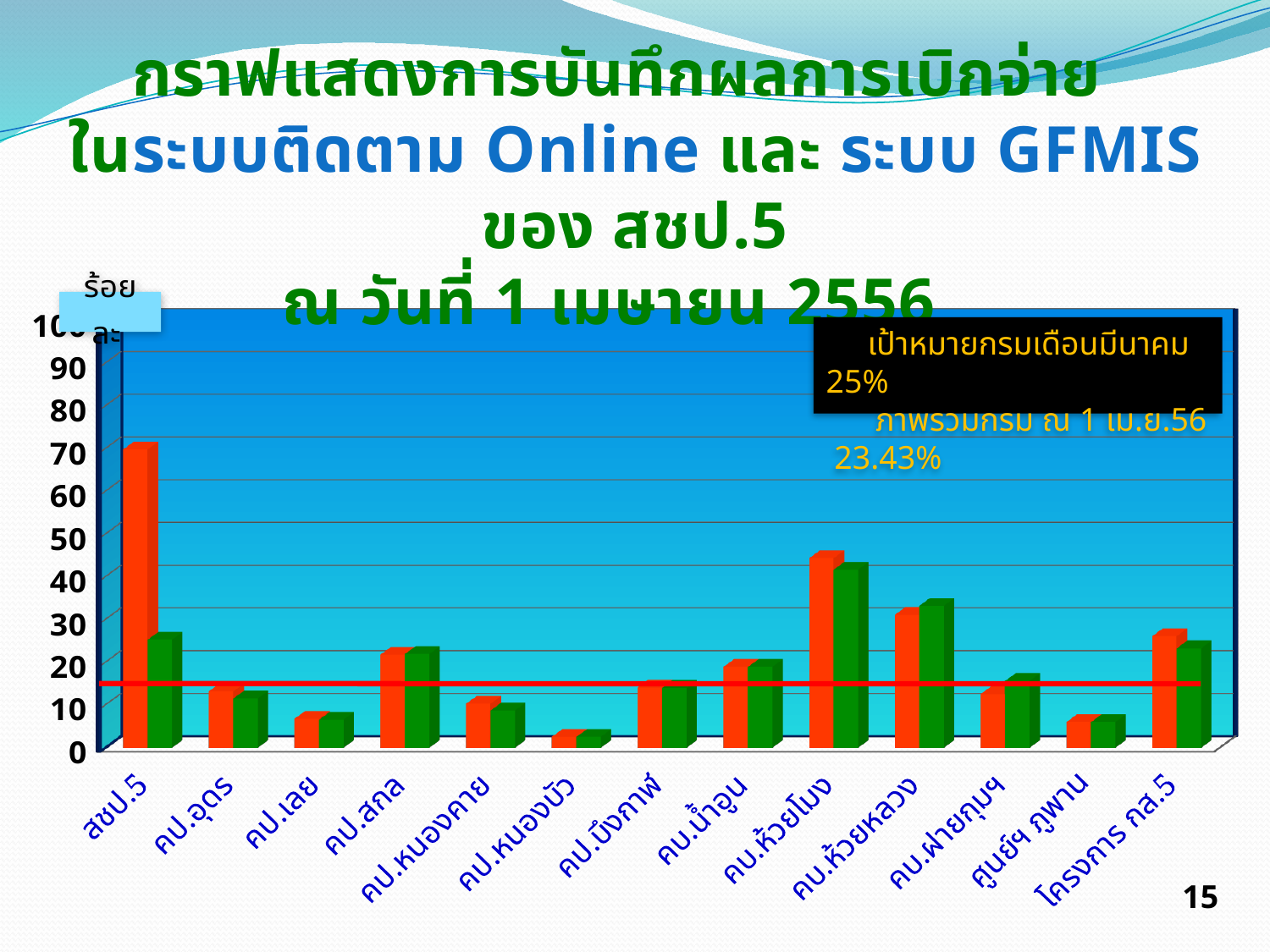
Is the orange bar for คบ.ห้วยโมง greater or less than 40? greater Which has the larger orange bar, สชป.5 or คบ.ห้วยโมง? สชป.5 Which category has the highest green bar? คบ.ห้วยโมง Which category has the highest orange bar? สชป.5 Is the green bar for สชป.5 greater or less than 20? greater Which has the larger orange bar, คบ.ห้วยหลวง or คป.เลย? คบ.ห้วยหลวง Which category has the lowest orange bar? คป.หนองบัว How many categories are shown along the x axis of the chart? 13 Is the orange bar for สชป.5 greater or less than 60? greater What kind of chart is shown on the slide? bar chart According to the text box on the chart, what is the department target for March (เป้าหมายกรมเดือนมีนาคม)? 25%